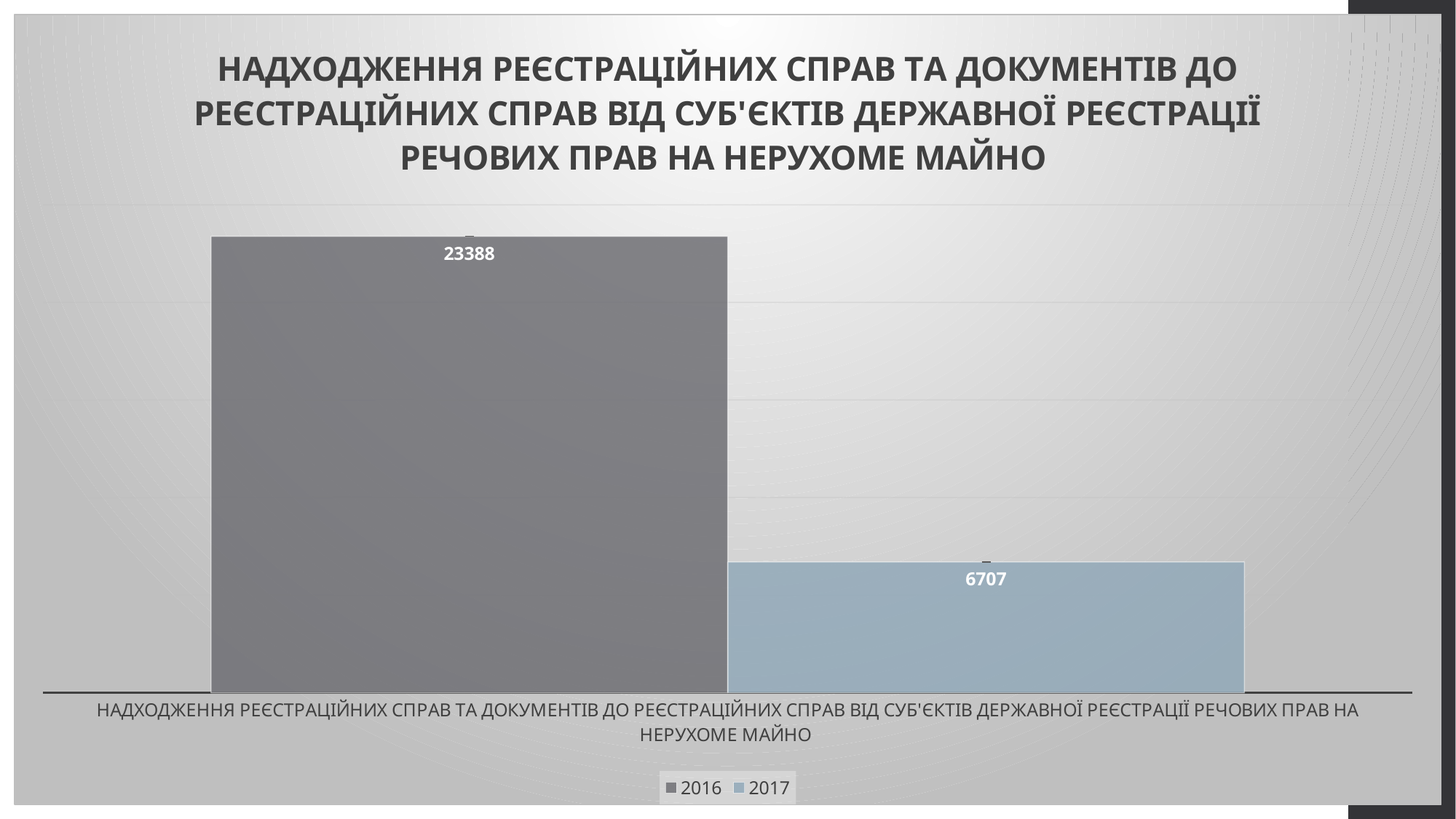
What is the value for 2016? 23388 Which series is shown in the lighter blue-grey colour? 2017 What years are listed in the legend? 2016 and 2017 What kind of chart is shown on the slide? Bar chart Did the value fall or rise from 2016 to 2017? Fall How many bars are plotted in the chart? 2 Which year has the highest value? 2016 Which series has the higher value, 2016 or 2017? 2016 What is the difference between the 2016 value and the 2017 value? 16681 What is the value for 2017? 6707 How many series does the legend list? 2 Which year has the lowest value? 2017